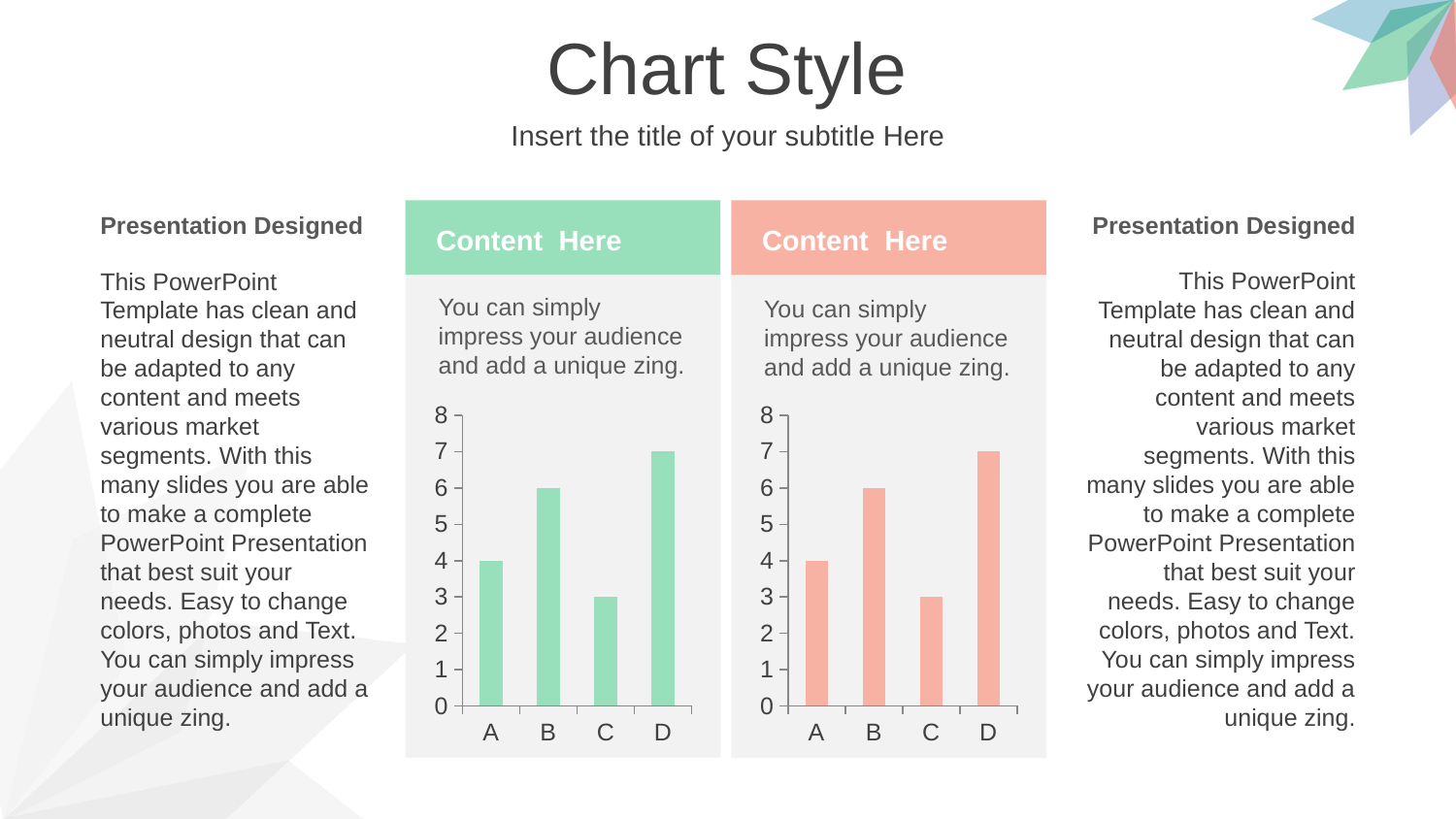
On the left chart, what is the difference between the values for B and C? 3 What kind of chart is the left chart? bar chart What is the maximum value shown on the y axis of the left chart? 8 On the right chart, which category has the lowest value? C On the right chart, what is the value for category B? 6 On the left chart, which category has the highest value? D On the right chart, which is larger, the value for A or the value for B? B How many categories are shown on the right chart? 4 On the left chart, what is the value for category D? 7 What colour are the bars on the right chart? pink On the right chart, what is the value for category A? 4 On the left chart, is the value for C greater or less than 5? less